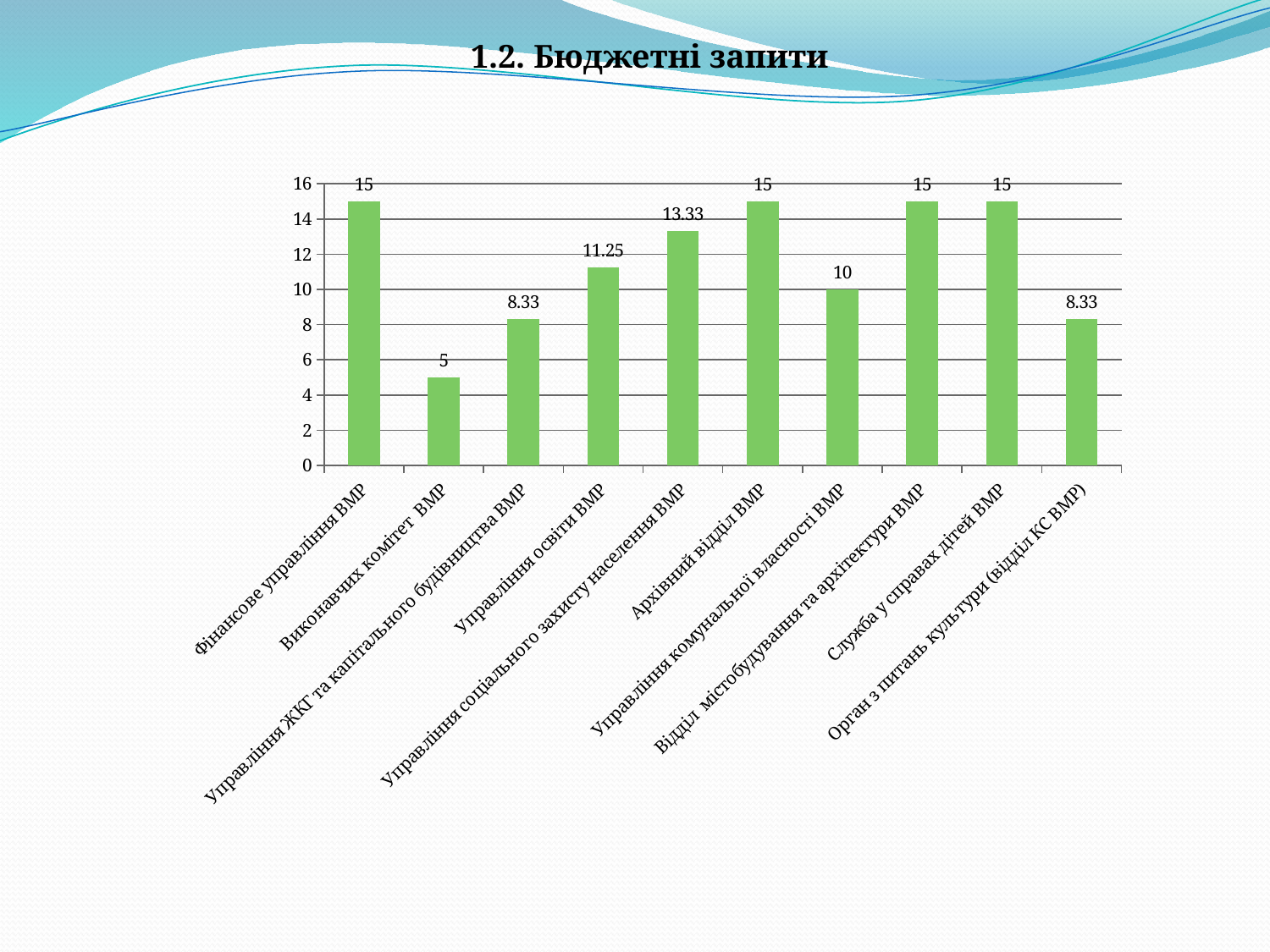
What is the value for Управління соціального захисту населення ВМР? 13.33 Which category has the lowest value? Виконавчих комітет ВМР What is the value for Виконавчих комітет ВМР? 5 How many categories are shown on the x axis? 10 Which is larger, the value for Управління освіти ВМР or the value for Управління ЖКГ та капітального будівництва ВМР? Управління освіти ВМР What is the value for Управління освіти ВМР? 11.25 What is the title of the slide? 1.2. Бюджетні запити What is the difference between the values for Фінансове управління ВМР and Виконавчих комітет ВМР? 10 What is the value for Орган з питань культури (відділ КС ВМР)? 8.33 What is the difference between the values for Управління соціального захисту населення ВМР and Управління освіти ВМР? 2.08 What is the value for Управління комунальної власності ВМР? 10 What kind of chart is shown on the slide? Bar chart